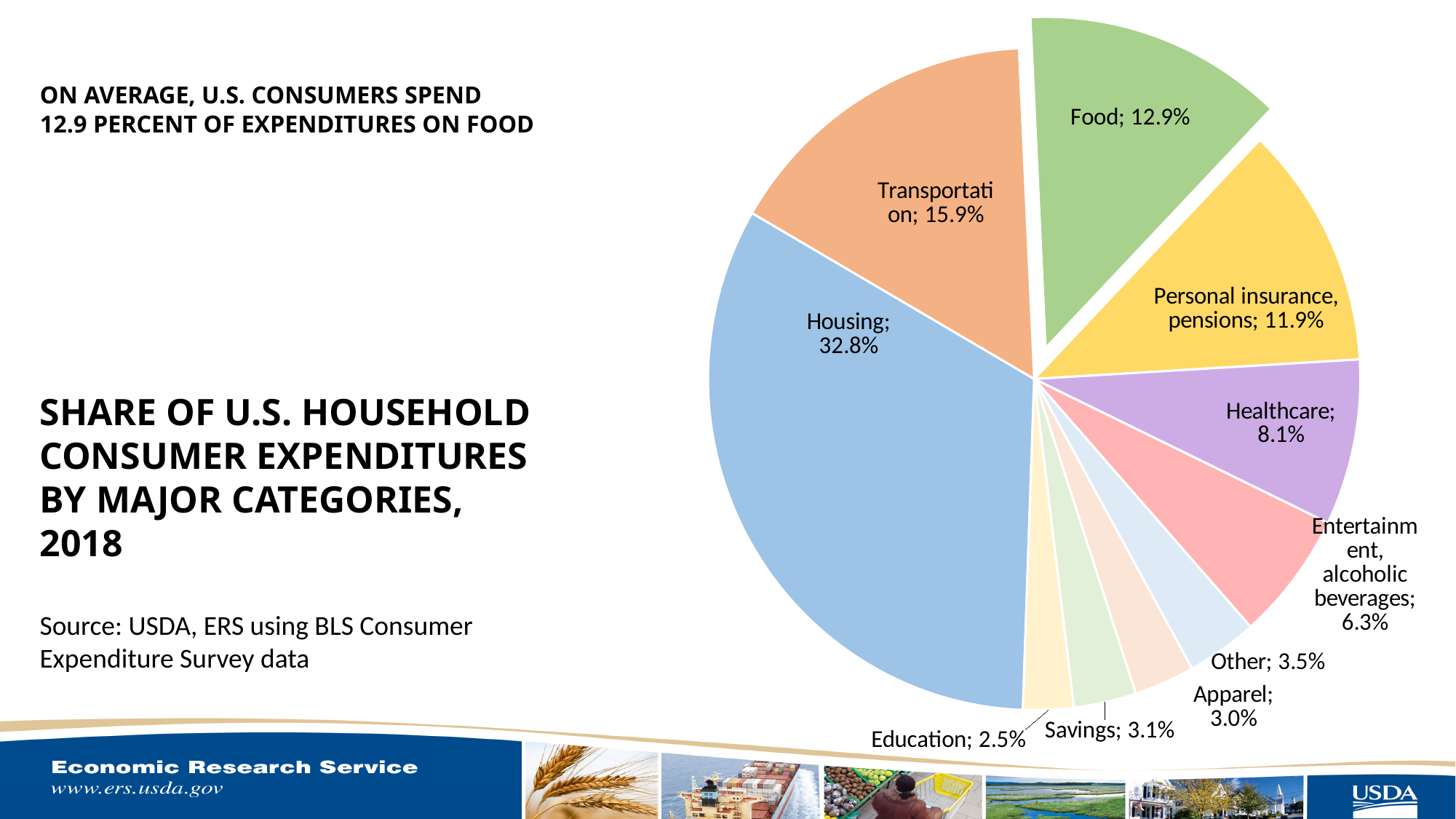
What share of expenditures goes to Education? 2.5% How many categories are shown in the pie chart? 10 What share of U.S. household consumer expenditures goes to Food? 12.9% Which category has the smallest share of expenditures? Education What is the difference in percentage points between Healthcare and Entertainment, alcoholic beverages? 1.8 What kind of chart is shown on the slide? pie chart Which category has the largest share of expenditures? Housing What share of expenditures goes to Healthcare? 8.1% What is the difference in percentage points between Housing and Transportation? 16.9 Which is larger, the share for Food or the share for Personal insurance, pensions? Food What share of expenditures goes to Housing? 32.8% What is the title of the chart? Share of U.S. household consumer expenditures by major categories, 2018